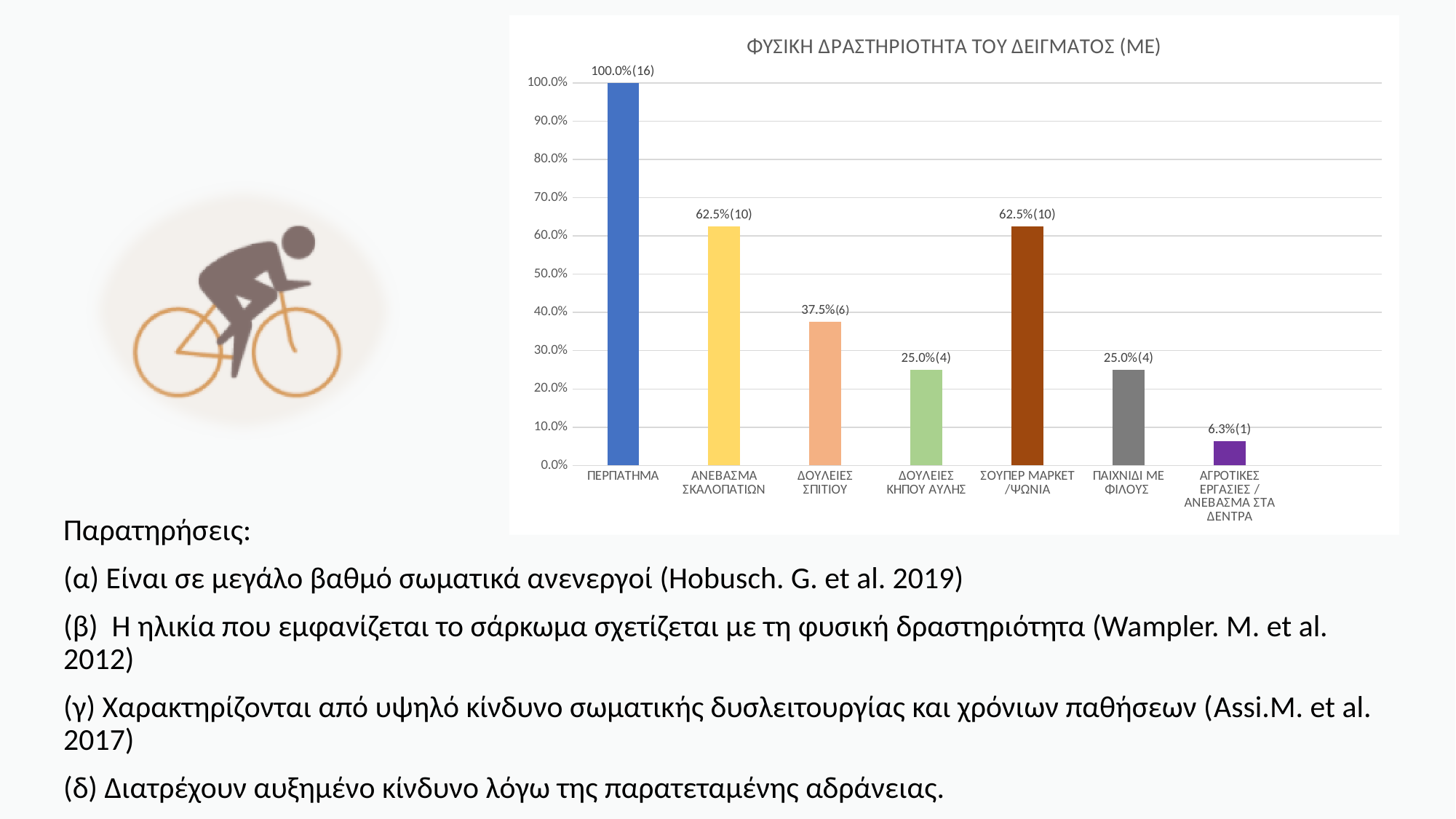
What kind of chart is shown on the slide? bar chart Which is larger, the value for ΔΟΥΛΕΙΕΣ ΣΠΙΤΙΟΥ or the value for ΠΑΙΧΝΙΔΙ ΜΕ ΦΙΛΟΥΣ? ΔΟΥΛΕΙΕΣ ΣΠΙΤΙΟΥ Which category has the highest value? ΠΕΡΠΑΤΗΜΑ What is the value for ΑΓΡΟΤΙΚΕΣ ΕΡΓΑΣΙΕΣ / ΑΝΕΒΑΣΜΑ ΣΤΑ ΔΕΝΤΡΑ? 6.3%(1) What colour is the bar for ΠΕΡΠΑΤΗΜΑ? blue How many categories are shown on the x axis? 7 What is the value for ΔΟΥΛΕΙΕΣ ΣΠΙΤΙΟΥ? 37.5%(6) Which category has the lowest value? ΑΓΡΟΤΙΚΕΣ ΕΡΓΑΣΙΕΣ / ΑΝΕΒΑΣΜΑ ΣΤΑ ΔΕΝΤΡΑ Is the value for ΣΟΥΠΕΡ ΜΑΡΚΕΤ /ΨΩΝΙΑ greater or less than 50.0%? greater What is the value for ΠΕΡΠΑΤΗΜΑ? 100.0%(16) What is the difference in percentage between ΠΕΡΠΑΤΗΜΑ and ΑΝΕΒΑΣΜΑ ΣΚΑΛΟΠΑΤΙΩΝ? 37.5% What is the title of the chart? ΦΥΣΙΚΗ ΔΡΑΣΤΗΡΙΟΤΗΤΑ ΤΟΥ ΔΕΙΓΜΑΤΟΣ (ΜΕ)